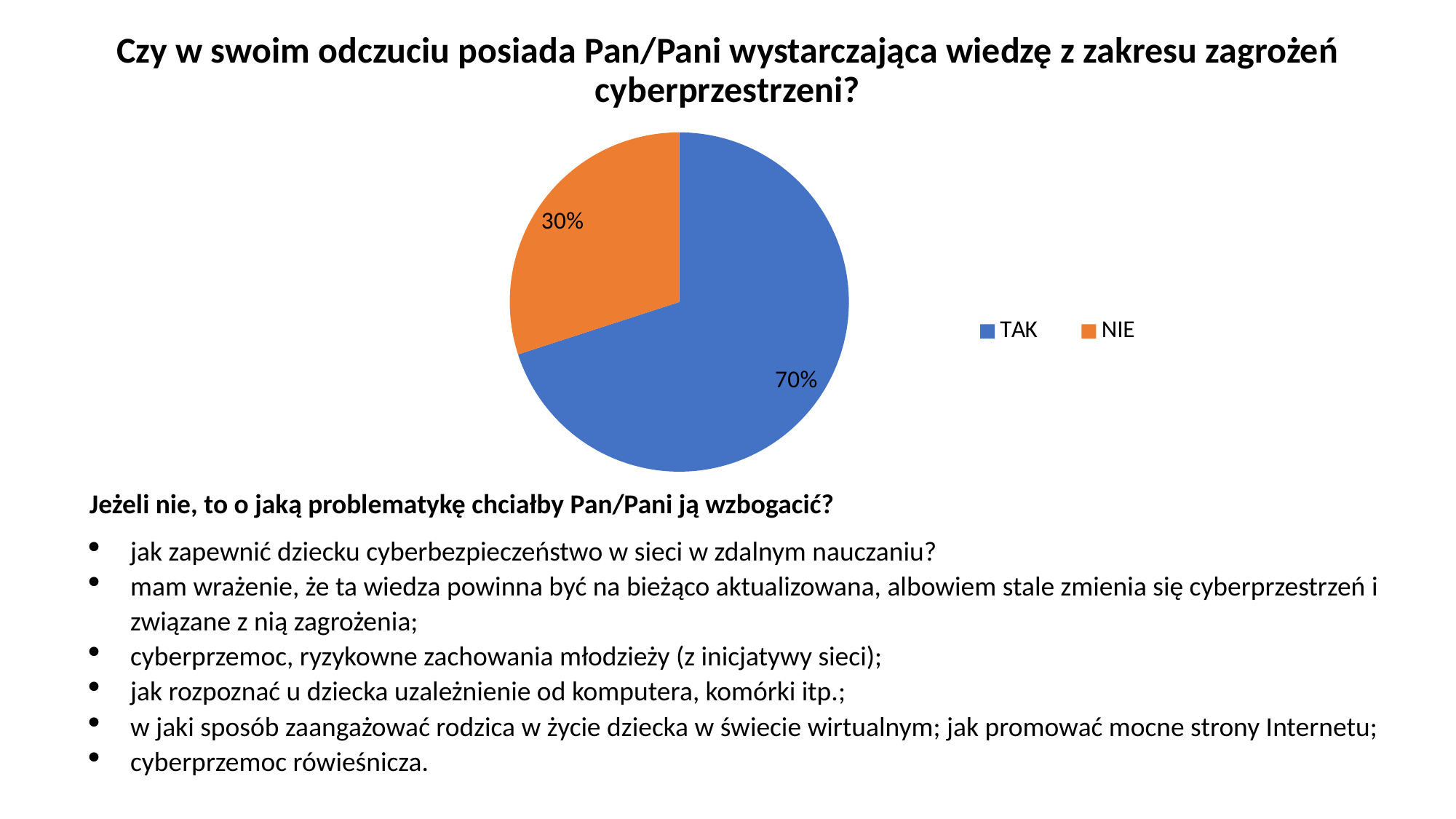
What percentage of respondents answered TAK? 70% What kind of chart is shown on the slide? pie chart What colour is the NIE slice? orange What colour is the TAK slice? blue What is the difference in percentage points between the TAK and NIE slices? 40 Which answer has the largest share of the pie? TAK Which slice is larger, TAK or NIE? TAK What percentage of respondents answered NIE? 30% What is the share of the pie taken by the NIE slice? 30% How many entries does the legend list? 2 How many slices does the pie chart have? 2 Which answer has the smallest share of the pie? NIE